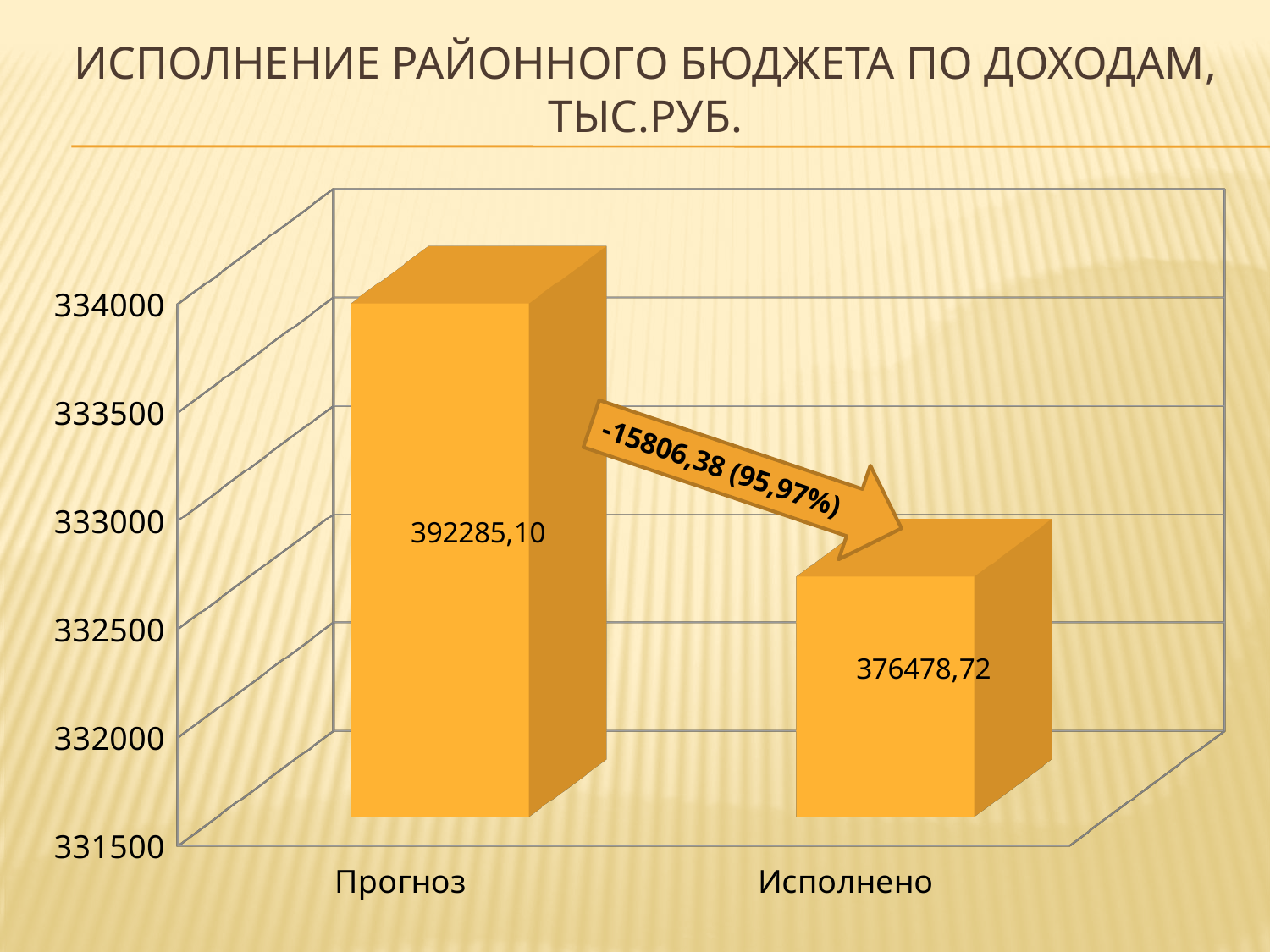
What text is written on the arrow between the two bars? -15806,38 (95,97%) What is the title of the slide? ИСПОЛНЕНИЕ РАЙОННОГО БЮДЖЕТА ПО ДОХОДАМ, ТЫС.РУБ. Which category has the highest value? Прогноз What is the value for Исполнено? 376478,72 Which is larger, the value for Прогноз or the value for Исполнено? Прогноз Do the values rise or fall from Прогноз to Исполнено? fall What kind of chart is shown on the slide? bar chart Which category has the lowest value? Исполнено How many categories are shown on the x axis? 2 What is the value for Прогноз? 392285,10 What is the lowest tick value shown on the vertical axis? 331500 What is the difference between the values for Прогноз and Исполнено? 15806,38